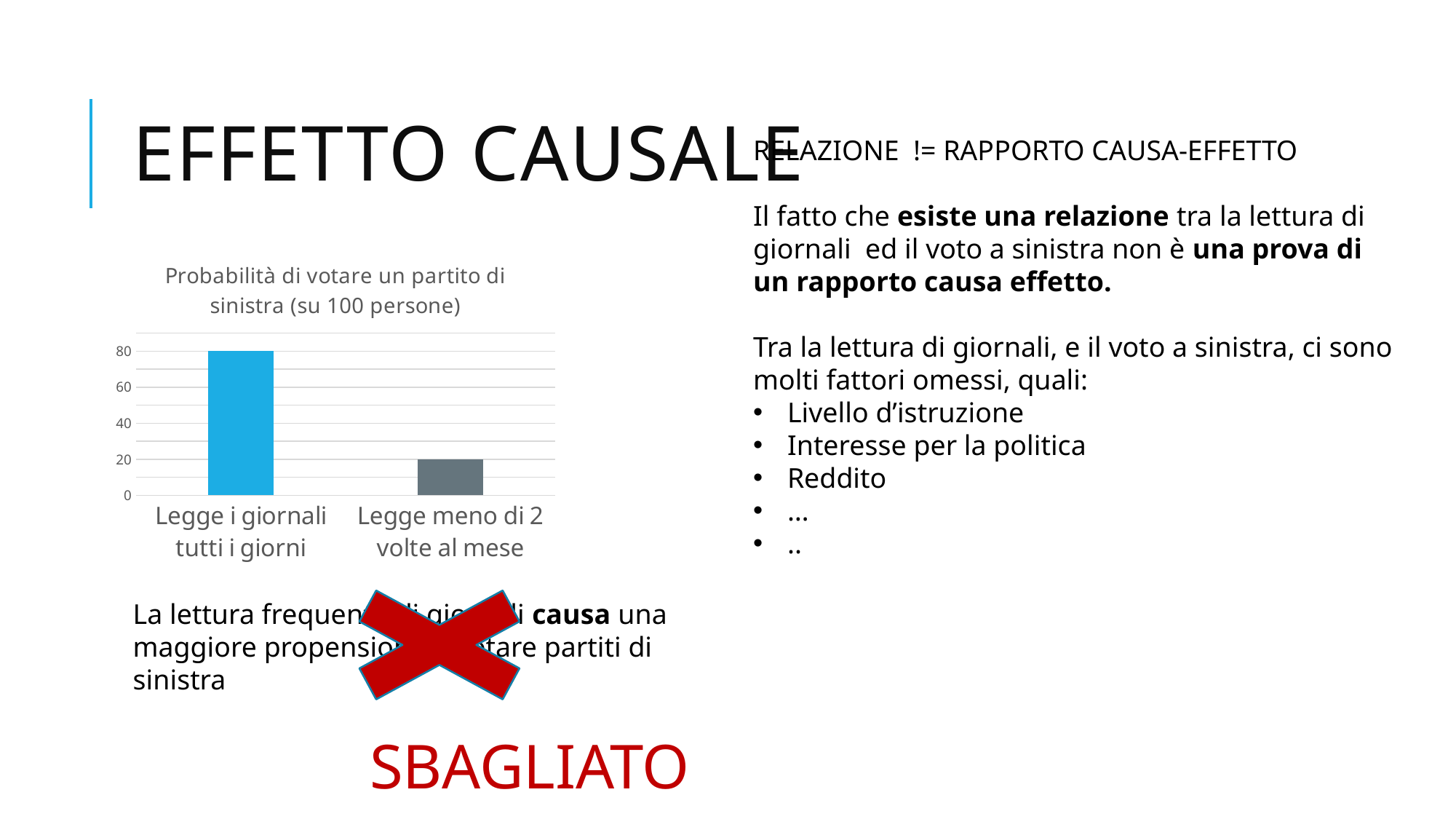
Is the value for "Legge i giornali tutti i giorni" greater or less than 60? greater Which is larger: the value for "Legge i giornali tutti i giorni" or for "Legge meno di 2 volte al mese"? Legge i giornali tutti i giorni What is the difference between the values for "Legge i giornali tutti i giorni" and "Legge meno di 2 volte al mese"? 60 What colour is the bar for "Legge i giornali tutti i giorni"? blue How many categories are shown in the chart? 2 What type of chart is shown on the slide? bar chart Which category has the lowest value? Legge meno di 2 volte al mese What is the title of the chart? Probabilità di votare un partito di sinistra (su 100 persone) Is the value for "Legge meno di 2 volte al mese" greater or less than 40? less What is the value for "Legge i giornali tutti i giorni"? 80 What is the value for "Legge meno di 2 volte al mese"? 20 Which category has the highest value? Legge i giornali tutti i giorni